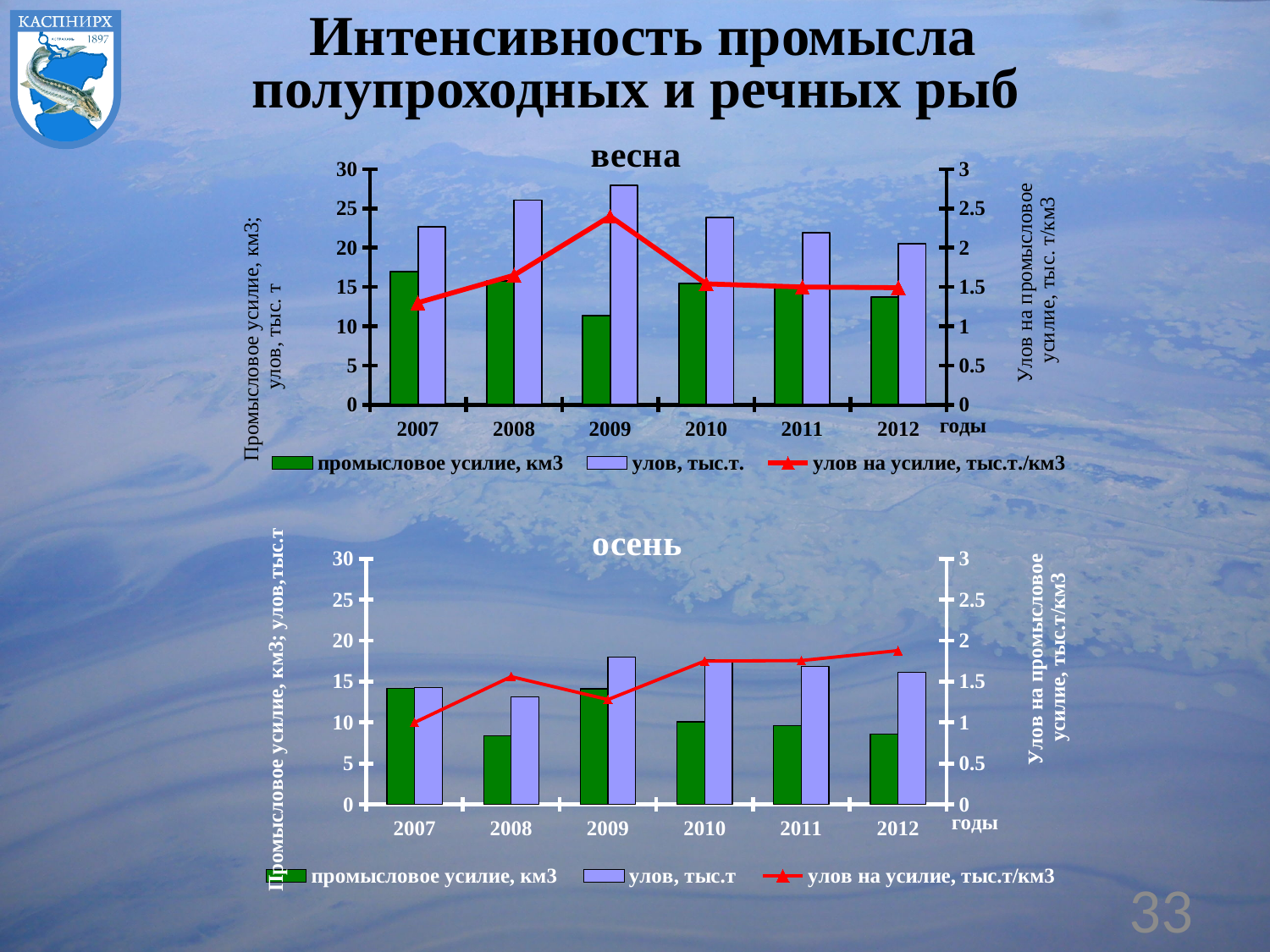
On the bottom chart (осень), which year has the highest улов на усилие, тыс.т/км3? 2012 On the bottom chart (осень), is the улов, тыс.т value for 2009 greater or less than 15? greater On the bottom chart (осень), is the промысловое усилие, км3 value for 2008 greater or less than 10? less On the top chart (весна), which year has the highest улов, тыс.т.? 2009 On the top chart (весна), which year has the lowest промысловое усилие, км3? 2009 On the top chart (весна), which year has the highest улов на усилие, тыс.т./км3? 2009 On the top chart (весна), is the промысловое усилие, км3 value for 2009 greater or less than 15? less How many series does the legend of the bottom chart (осень) list? 3 How many years are shown on the x axis of the top chart (весна)? 6 On the top chart (весна), which year has the larger улов, тыс.т.: 2008 or 2012? 2008 What kind of chart is the bottom chart (осень)? Bar chart combined with a line